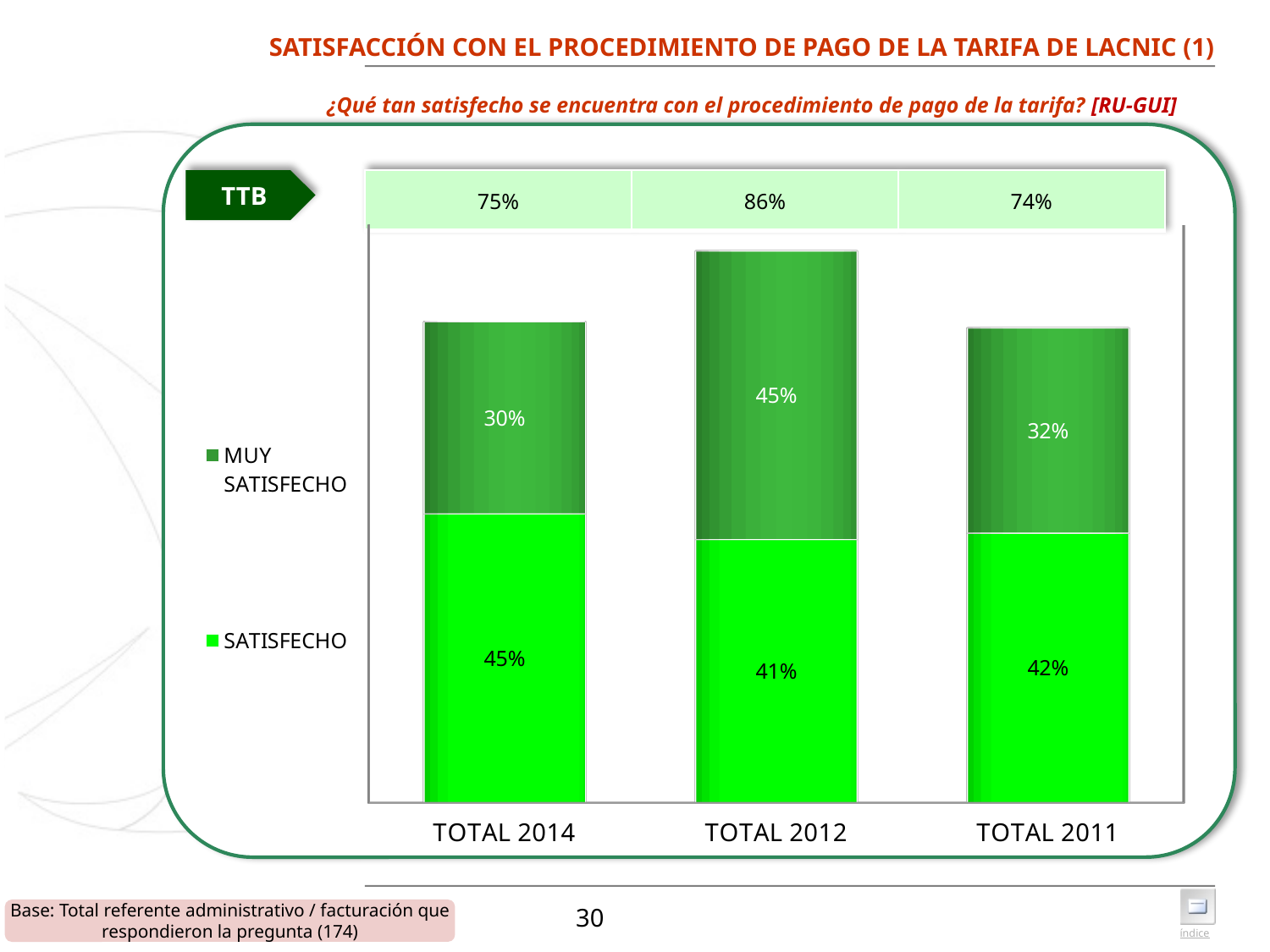
How many categories are shown on the x axis? 3 What is the total of the stacked bar for TOTAL 2011? 74% What is the value for MUY SATISFECHO in TOTAL 2011? 32% What is the TTB value shown for TOTAL 2012? 86% What is the difference between the MUY SATISFECHO values for TOTAL 2012 and TOTAL 2014? 15% Which category has the highest MUY SATISFECHO value? TOTAL 2012 How many series does the legend list? 2 What kind of chart is shown on the slide? Stacked bar chart What is the value for MUY SATISFECHO in TOTAL 2014? 30% What is the value for SATISFECHO in TOTAL 2012? 41% Which is larger, the SATISFECHO value for TOTAL 2014 or for TOTAL 2011? TOTAL 2014 Which category has the lowest SATISFECHO value? TOTAL 2012